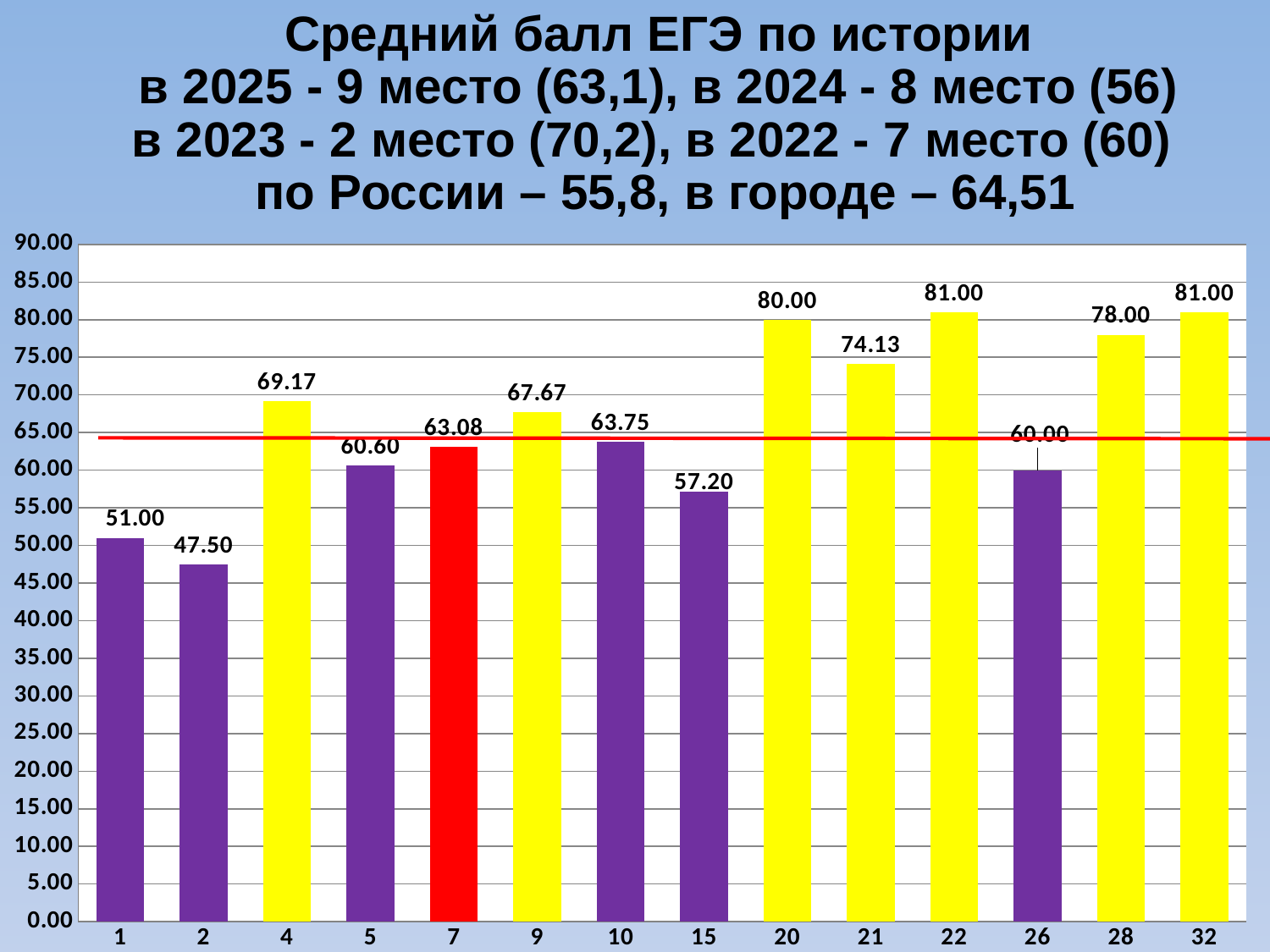
Which category has the lowest value? 2 How many bars are plotted in the chart? 14 What type of chart is shown on the slide? bar chart Which is larger, the value for category 4 or the value for category 9? category 4 What is the value for category 21? 74.13 What is the difference between the values for category 20 and category 1? 29.00 What is the difference between the values for category 10 and category 5? 3.15 What is the value for category 7? 63.08 What colour is the bar for category 7? red What is the highest value shown in the chart? 81.00 Is the value for category 28 greater or less than 75.00? greater What is the value for category 15? 57.20